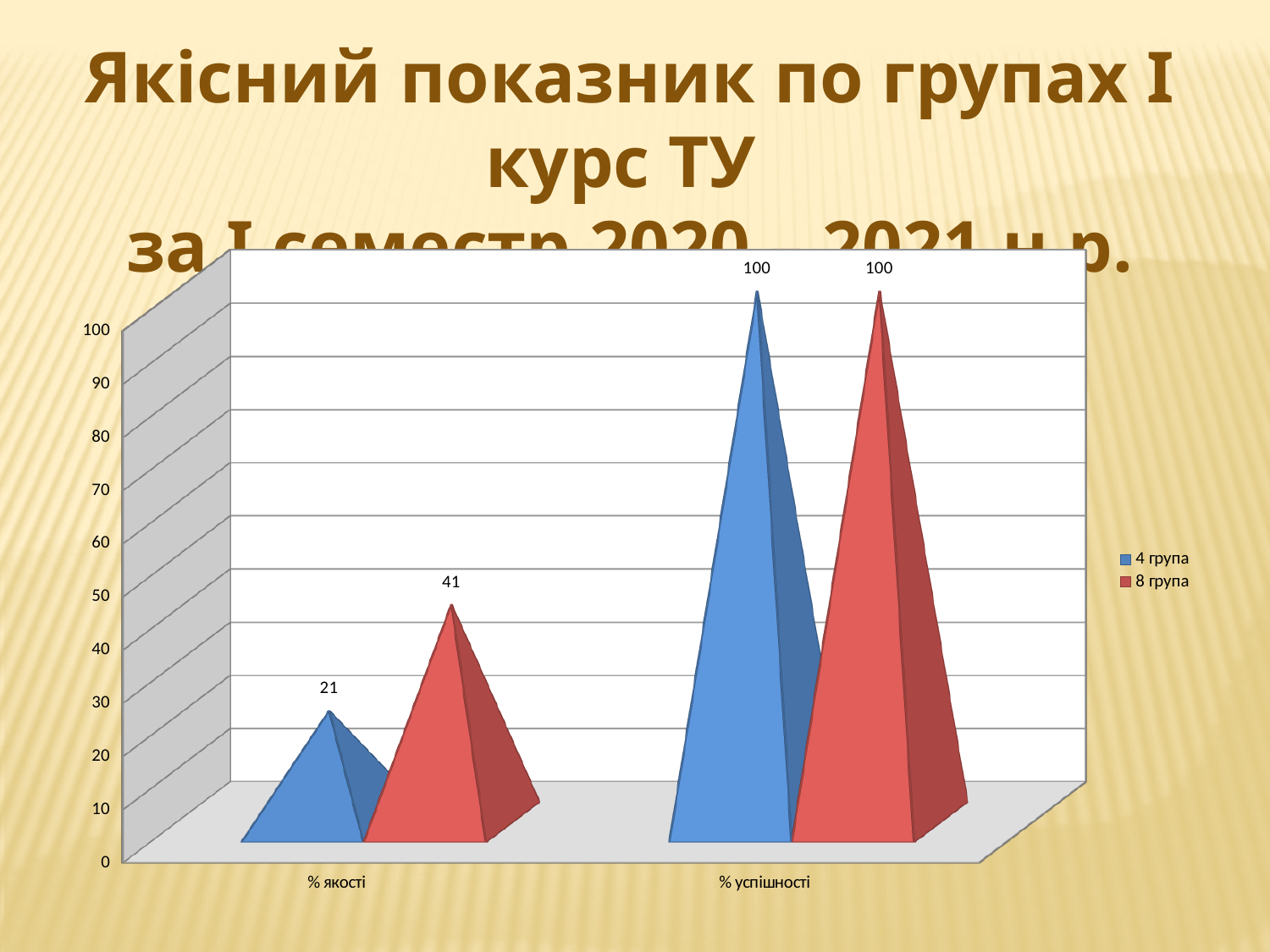
What kind of chart is shown on the slide? Bar chart What is the value for 8 група in the % якості category? 41 What is the value for 4 група in the % успішності category? 100 What is the value for 4 група in the % якості category? 21 Which category has the lowest value for 4 група? % якості What are the two series names listed in the legend? 4 група and 8 група Which colour represents 8 група in the chart? Red How many categories are shown on the x axis? 2 What is the difference between the 8 група and 4 група values in the % якості category? 20 What is the value for 8 група in the % успішності category? 100 How many series does the legend list? 2 Which group has the higher value in the % якості category? 8 група